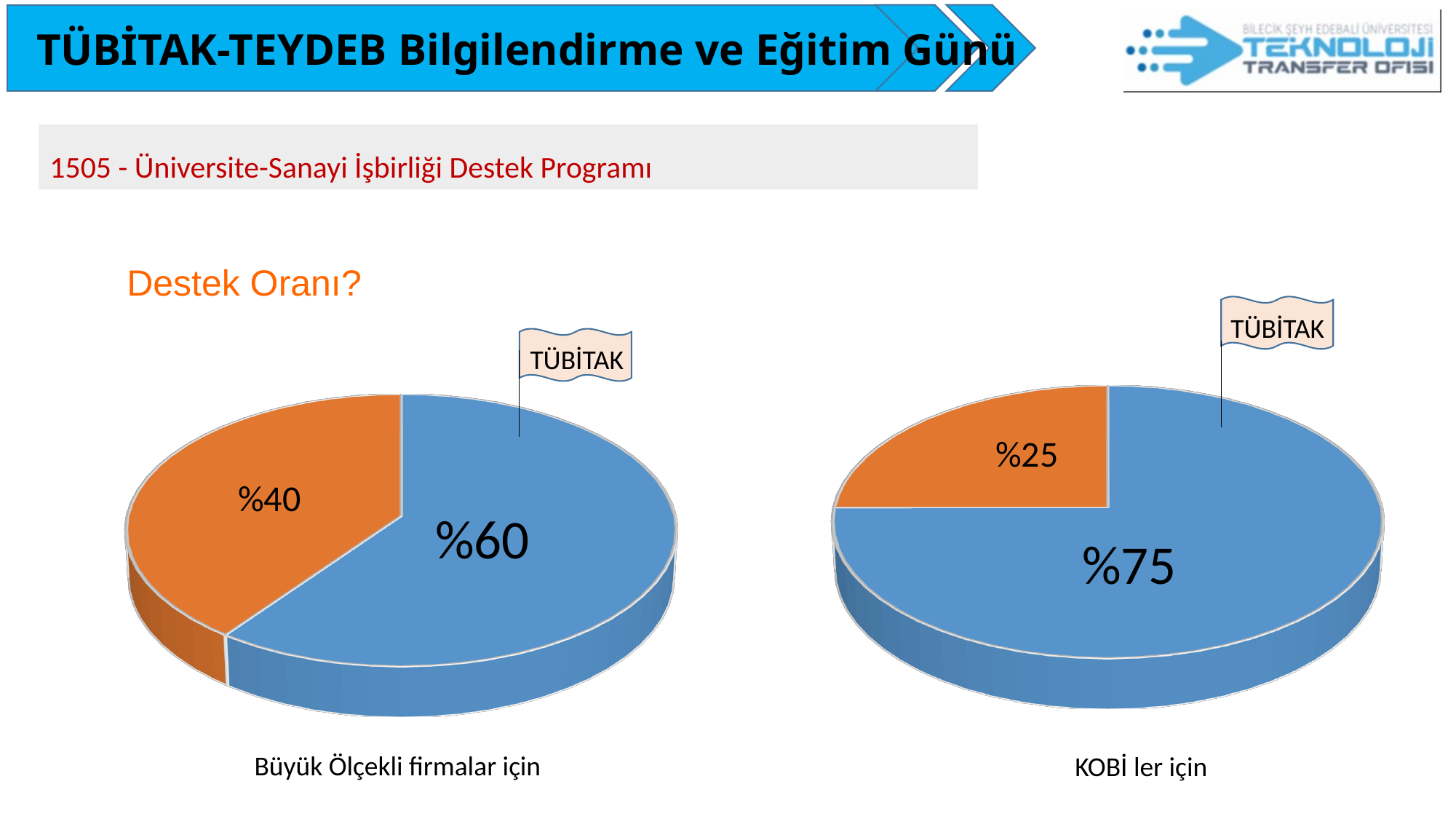
What colour is the TÜBİTAK slice in both pie charts? Blue In the left pie chart (Büyük Ölçekli firmalar için), what is the difference between the blue slice and the orange slice? 20 percentage points What kind of chart is shown for Büyük Ölçekli firmalar için? Pie chart How many slices does the right pie chart (KOBİ ler için) have? 2 In the right pie chart (KOBİ ler için), what share is labelled TÜBİTAK? %75 Which pie chart shows the higher TÜBİTAK share, the left one (Büyük Ölçekli firmalar için) or the right one (KOBİ ler için)? The right one (KOBİ ler için) What is the difference between the TÜBİTAK share in the right pie chart (KOBİ ler için) and the TÜBİTAK share in the left pie chart (Büyük Ölçekli firmalar için)? 15 percentage points In the left pie chart (Büyük Ölçekli firmalar için), which slice is larger, the blue TÜBİTAK slice or the orange slice? The blue TÜBİTAK slice In the right pie chart (KOBİ ler için), which slice is the smallest? The orange slice (%25) In the left pie chart (Büyük Ölçekli firmalar için), what is the value of the orange slice? %40 In the right pie chart (KOBİ ler için), what is the value of the orange slice? %25 In the left pie chart (Büyük Ölçekli firmalar için), what share is labelled TÜBİTAK? %60